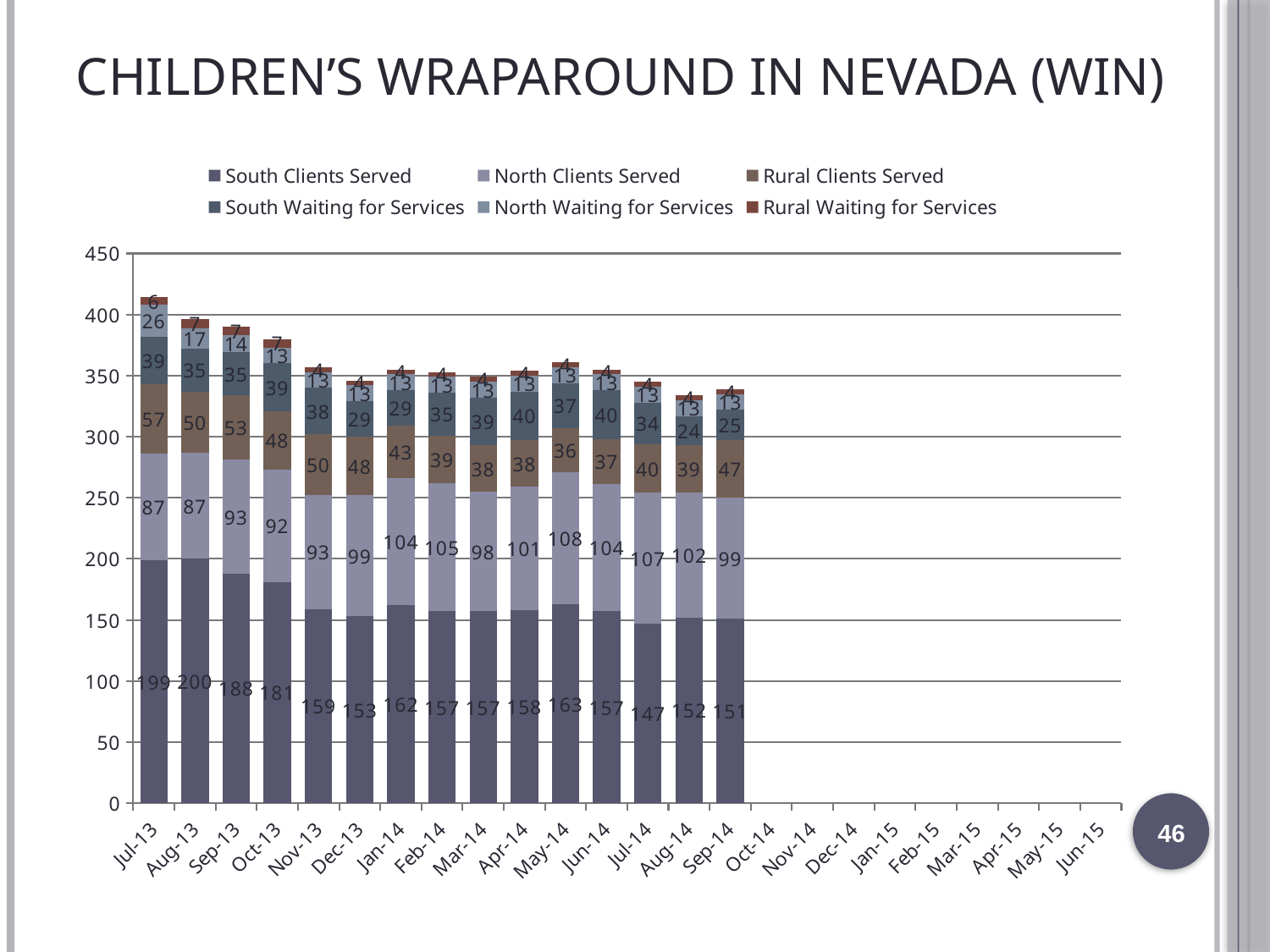
How many series does the legend list? 6 What is the value of North Waiting for Services for Jul-13? 26 What is the value of South Clients Served for Aug-13? 200 What is the value of Rural Clients Served for Jul-13? 57 What is the total height of the stacked bar for Sep-14? 339 Which is larger, Rural Clients Served in Sep-14 or Rural Clients Served in Aug-14? Sep-14 What is the value of North Clients Served for May-14? 108 In which month is South Clients Served the lowest? Jul-14 Does South Clients Served generally rise or fall from Jul-13 to Sep-14? fall What type of chart is shown on the slide? stacked bar chart In which month is South Clients Served the highest? Aug-13 What is the difference between South Clients Served in Jul-13 and Sep-14? 48